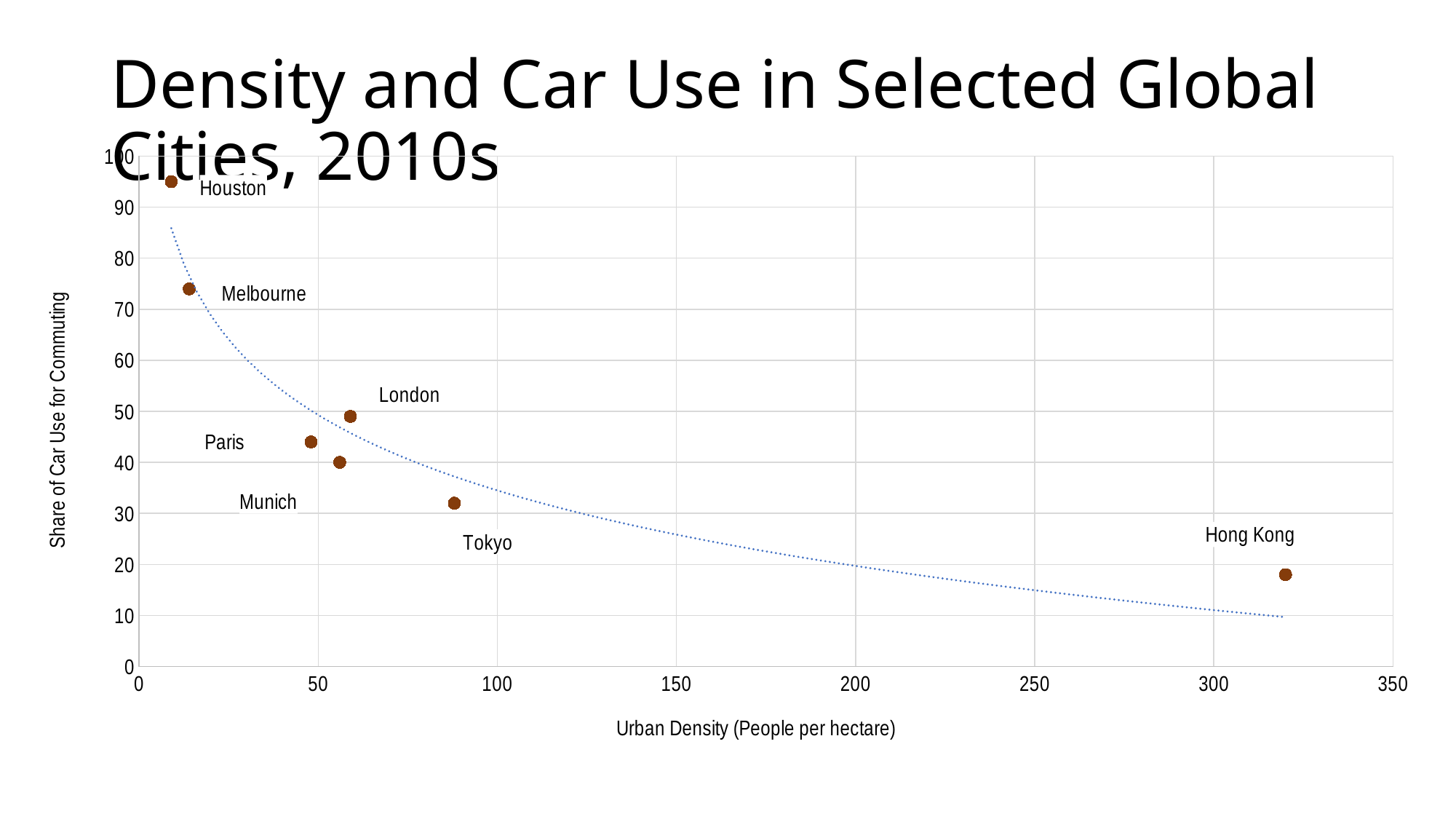
As urban density increases along the x axis, does the share of car use for commuting generally rise or fall? Fall Is the share of car use for commuting for Houston greater or less than 90? greater Which city has the highest share of car use for commuting? Houston Is the urban density for Hong Kong greater or less than 300? greater Is the share of car use for commuting for Tokyo greater or less than 40? less What is the title of the x axis? Urban Density (People per hectare) Which city has the lowest share of car use for commuting? Hong Kong What kind of chart is shown on the slide? Scatter chart Which city has a higher share of car use for commuting, Melbourne or Tokyo? Melbourne Which city has the highest urban density? Hong Kong How many cities are plotted on the chart? 7